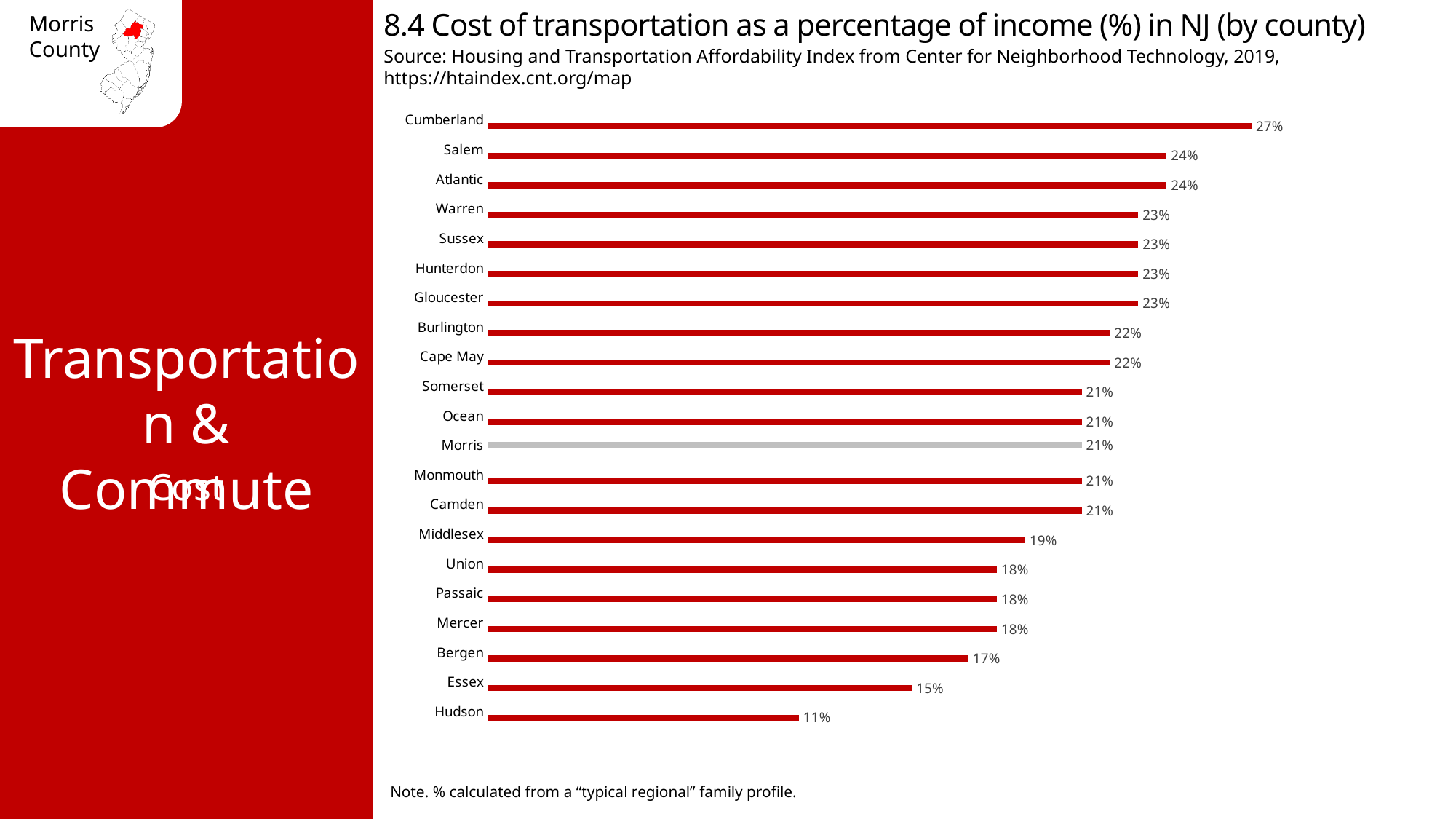
Which has a higher value, Essex or Bergen? Bergen Which county's bar is shown in grey rather than red? Morris What is the value shown for Bergen County? 17% What is the value shown for Hudson County? 11% What is the difference in percentage points between Morris and Essex? 6 What type of chart is used on this slide? Bar chart How many counties are shown in the chart? 21 What is the difference in percentage points between Cumberland and Hudson? 16 Which county has the highest cost of transportation as a percentage of income? Cumberland What is the cost of transportation as a percentage of income for Morris County? 21% Which has a higher value, Middlesex or Union? Middlesex Which county has the lowest cost of transportation as a percentage of income? Hudson